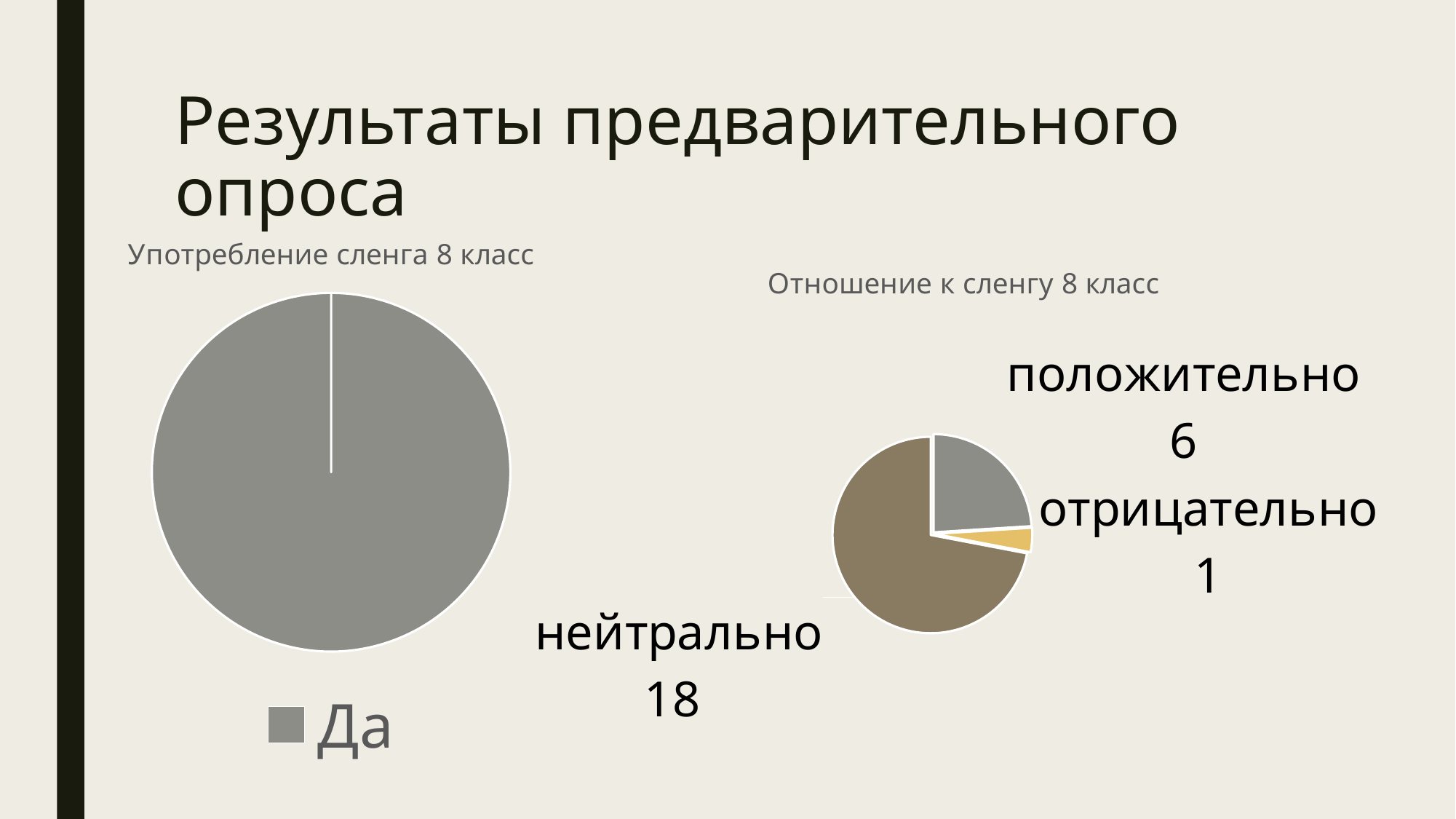
In the chart titled "Отношение к сленгу 8 класс", which is larger: положительно or отрицательно? положительно In the chart titled "Употребление сленга 8 класс", what is the only entry listed in the legend? Да In the chart titled "Отношение к сленгу 8 класс", how many categories are shown? 3 In the chart titled "Отношение к сленгу 8 класс", what is the difference between the values for нейтрально and положительно? 12 In the chart titled "Отношение к сленгу 8 класс", what is the value for нейтрально? 18 In the chart titled "Отношение к сленгу 8 класс", what is the value for отрицательно? 1 What kind of chart is the chart titled "Употребление сленга 8 класс"? pie chart In the chart titled "Отношение к сленгу 8 класс", what is the total of all slices? 25 In the chart titled "Отношение к сленгу 8 класс", which category has the highest value? нейтрально In the chart titled "Отношение к сленгу 8 класс", what share of the pie does нейтрально represent? 72% In the chart titled "Отношение к сленгу 8 класс", what is the value for положительно? 6 In the chart titled "Отношение к сленгу 8 класс", which category has the lowest value? отрицательно